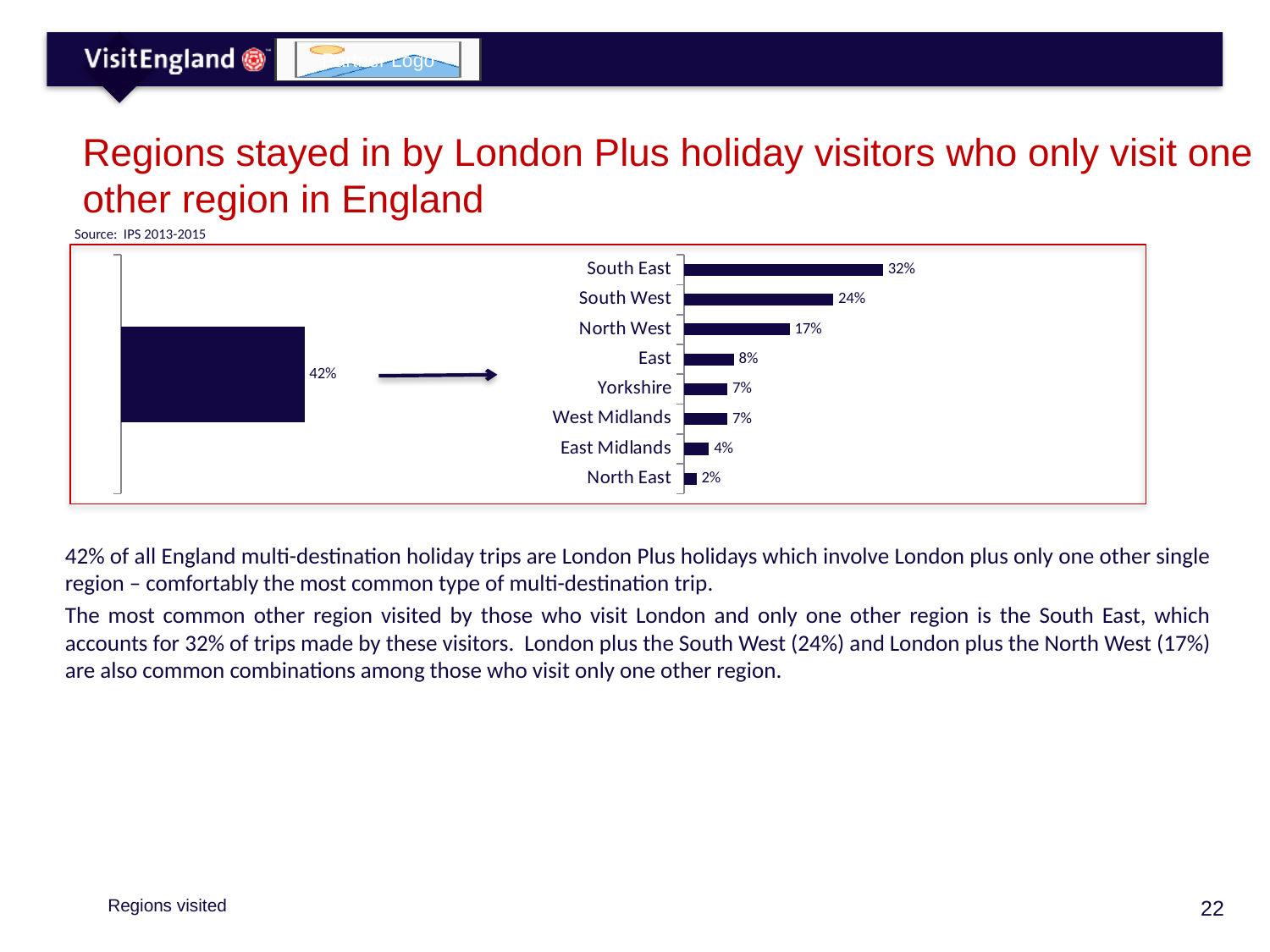
What kind of chart is the chart on the right of the slide? Bar chart In the bar chart on the right, what is the value for North West? 17% In the bar chart on the right, which region has the lowest value? North East In the bar chart on the right, what is the difference between the values for South East and South West? 8% In the bar chart on the right, what is the value for East Midlands? 4% In the bar chart on the right, how many regions are shown? 8 In the bar chart on the right, which is larger, the value for South West or the value for North West? South West What value is labelled on the single bar in the chart on the left of the slide? 42% In the bar chart on the right, what is the value for South East? 32% In the bar chart on the right, which region has the highest value? South East In the bar chart on the right, which two regions share the same value of 7%? Yorkshire and West Midlands In the bar chart on the right, what is the difference between the values for North West and East? 9%